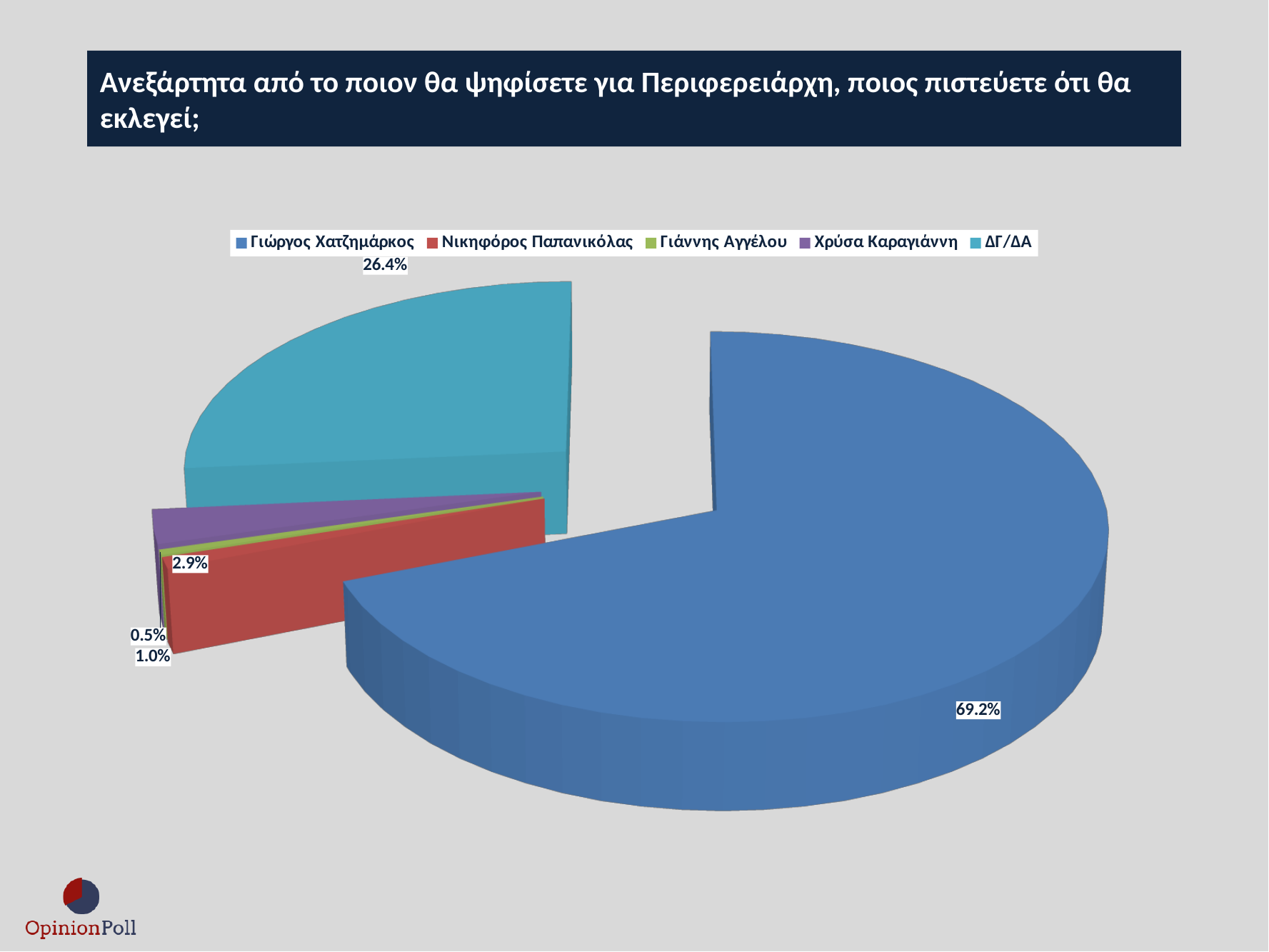
What percentage is shown for Γιώργος Χατζημάρκος? 69.2% What is the difference between the shares of Γιώργος Χατζημάρκος and ΔΓ/ΔΑ? 42.8% What is the title of the slide above the chart? Ανεξάρτητα από το ποιον θα ψηφίσετε για Περιφερειάρχη, ποιος πιστεύετε ότι θα εκλεγεί; Which category has the largest share of the pie? Γιώργος Χατζημάρκος What type of chart is shown on the slide? pie chart Which colour represents ΔΓ/ΔΑ in the pie chart? teal (light blue) What percentage is shown for ΔΓ/ΔΑ? 26.4% What percentage is shown for Νικηφόρος Παπανικόλας? 1.0% How many categories does the legend list? 5 Is the share for Γιώργος Χατζημάρκος greater or less than 50%? greater What is the smallest percentage value labelled on the pie chart? 0.5% Which is larger, the share for ΔΓ/ΔΑ or the share for Νικηφόρος Παπανικόλας? ΔΓ/ΔΑ